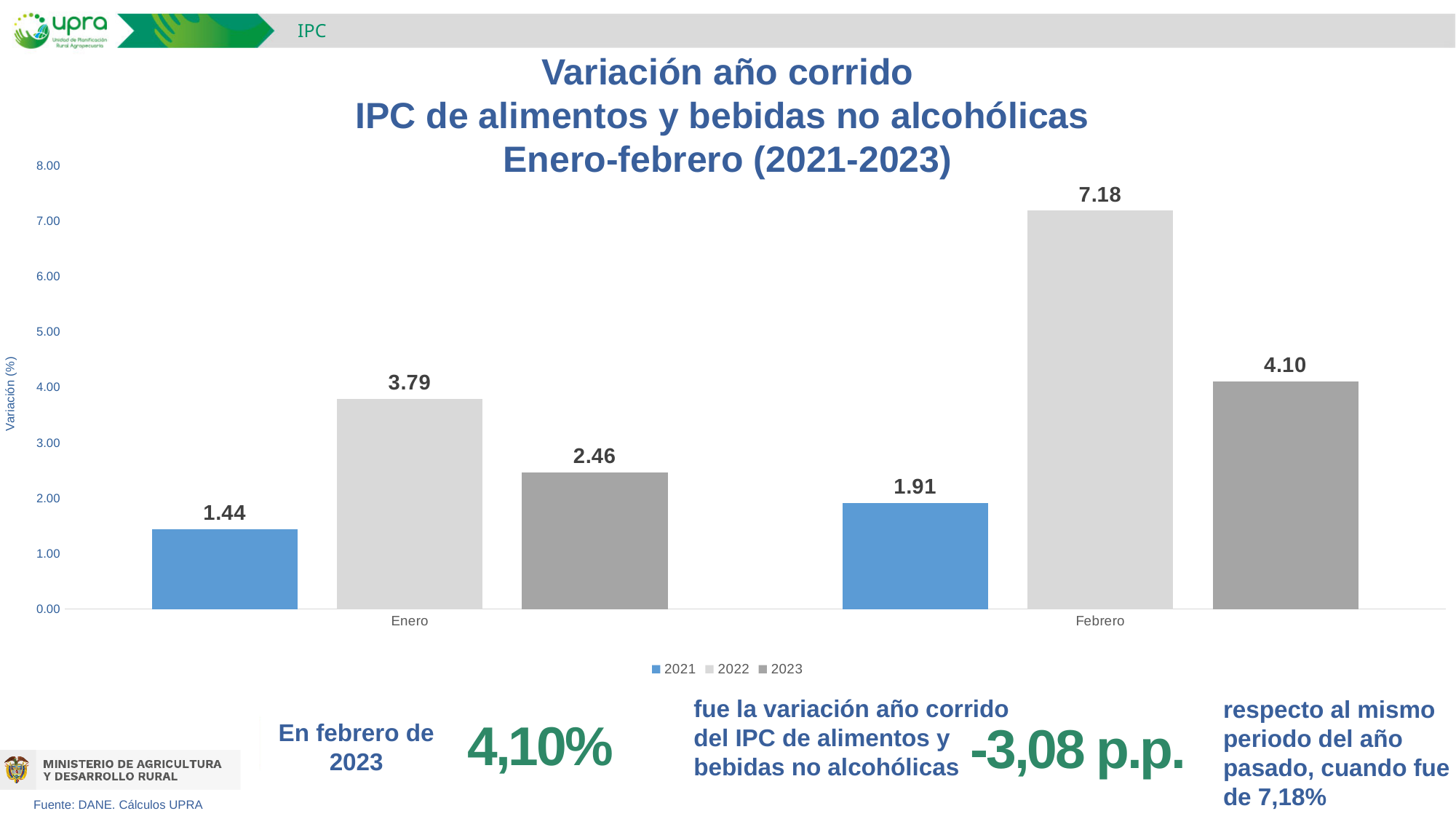
What is the value for 2023 in Febrero? 4.10 What kind of chart is shown on the slide? bar chart Which series has the lowest value in Enero? 2021 Which is larger: the 2023 value in Enero or the 2021 value in Febrero? 2023 value in Enero What is the difference between the 2021 values in Febrero and Enero? 0.47 Is the value for 2022 in Febrero greater or less than 7.00? greater What is the value for 2022 in Enero? 3.79 What is the difference between the 2022 and 2023 values in Febrero? 3.08 Which series has the highest value in Febrero? 2022 How many series does the legend list? 3 What is the value for 2021 in Enero? 1.44 What is the label of the vertical axis? Variación (%)